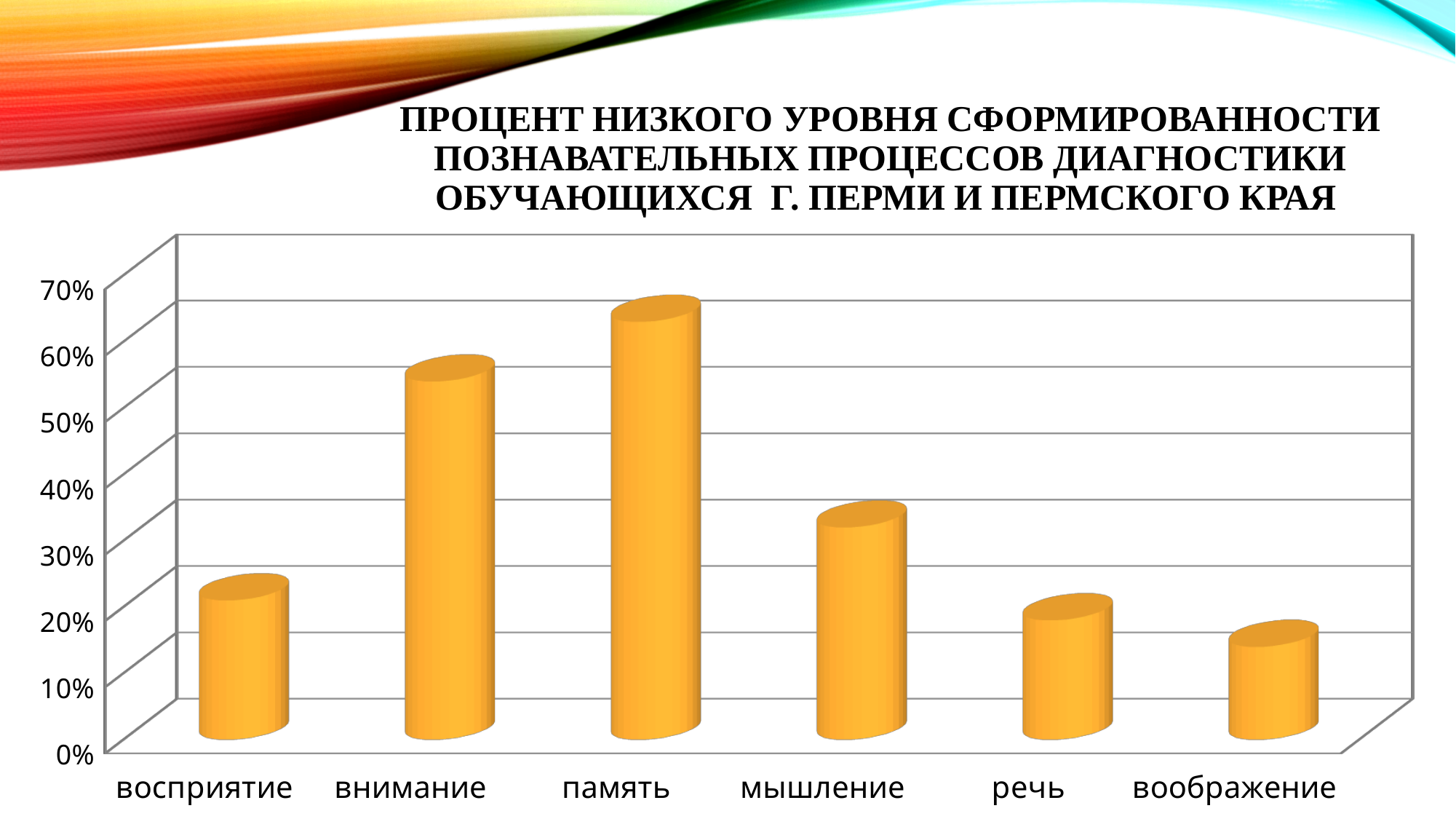
Which is larger, the value for память or the value for внимание? память What kind of chart is shown on the slide? bar chart Is the value for восприятие greater or less than 30%? less Is the value for воображение greater or less than 30%? less How many categories are shown on the x axis of the chart? 6 Which is larger, the value for внимание or the value for мышление? внимание Which category has the lowest value in the chart? воображение Do the values rise or fall along the x axis from память to воображение? fall Which category has the highest value in the chart? память Is the value for внимание greater or less than 40%? greater